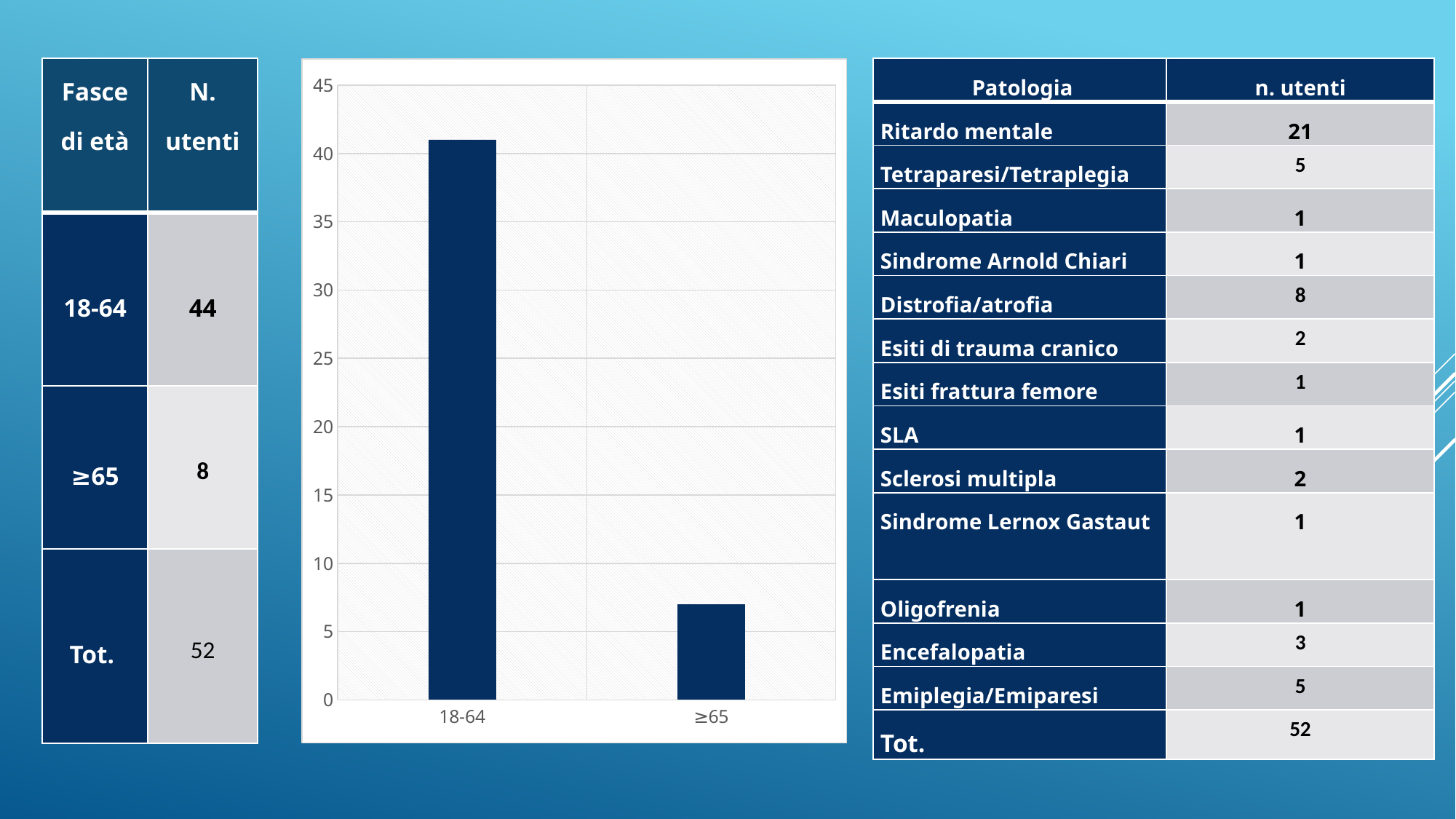
What is the label of the first category on the chart's x axis? 18-64 What is the highest tick value shown on the chart's vertical axis? 45 Is the value for 18-64 greater or less than 40? greater How many categories are plotted on the x axis of the chart? 2 Which bar is taller in the chart, 18-64 or ≥65? 18-64 Is the value for ≥65 greater or less than 5? greater Is the value for ≥65 greater or less than 10? less Which category has the highest bar in the chart? 18-64 Do the bar values rise or fall from 18-64 to ≥65 along the x axis? fall Which category has the lowest bar in the chart? ≥65 What kind of chart is shown on the slide? bar chart